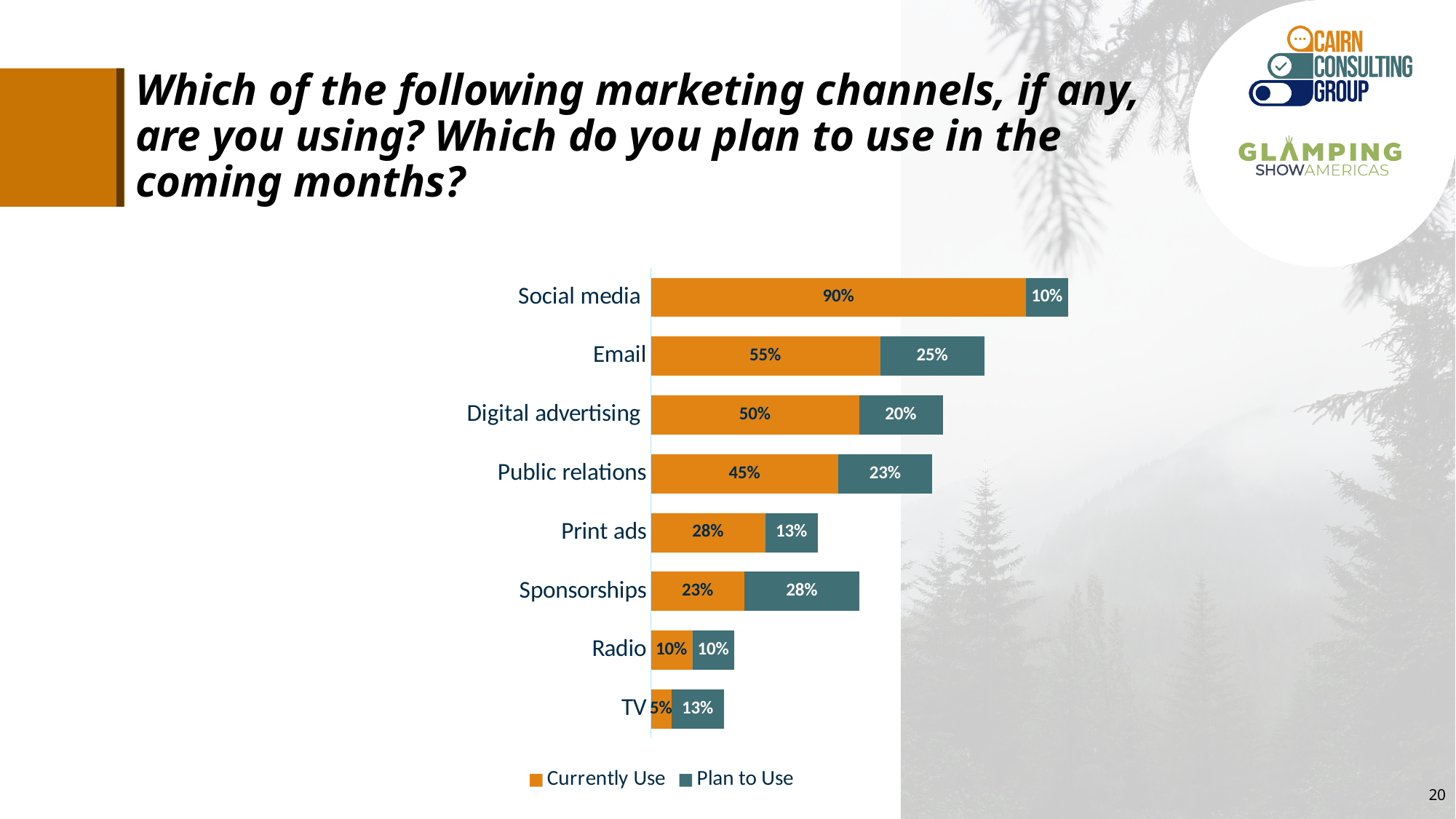
What is the combined total of 'Currently Use' and 'Plan to Use' for public relations? 68% How many marketing channels are shown in the chart? 8 Which colour represents the 'Plan to Use' series? Dark teal Which marketing channel has the lowest 'Currently Use' percentage? TV What is the difference between the 'Currently Use' percentages for email and digital advertising? 5% What percentage of respondents plan to use email? 25% What percentage of respondents currently use social media? 90% Which is larger for sponsorships: the 'Currently Use' value or the 'Plan to Use' value? Plan to Use What is the 'Currently Use' value for sponsorships? 23% What kind of chart is shown on the slide? Stacked bar chart Which marketing channel has the highest 'Currently Use' percentage? Social media How many series does the legend list? 2